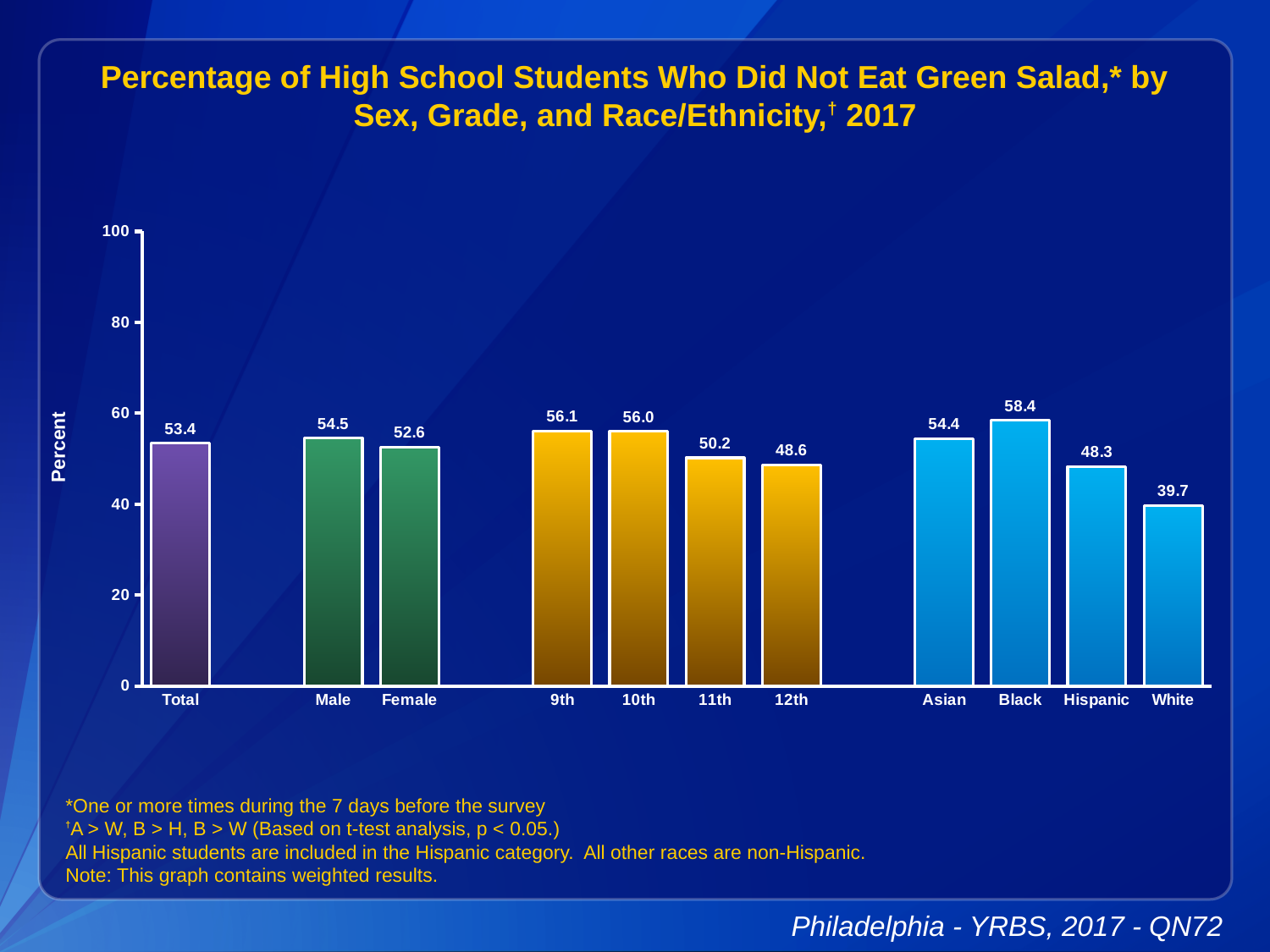
Which is larger, the value for 9th grade or 12th grade? 9th What is the value for 11th grade? 50.2 What is the value for Female? 52.6 What is the difference between the values for Black and White? 18.7 Which category has the lowest value? White What is the difference between the values for Male and Female? 1.9 How many bars are shown in the chart? 11 What kind of chart is shown on the slide? bar chart What is the value for Hispanic? 48.3 Which category has the highest value? Black What is the value for Total? 53.4 Is the value for White greater or less than 40? less